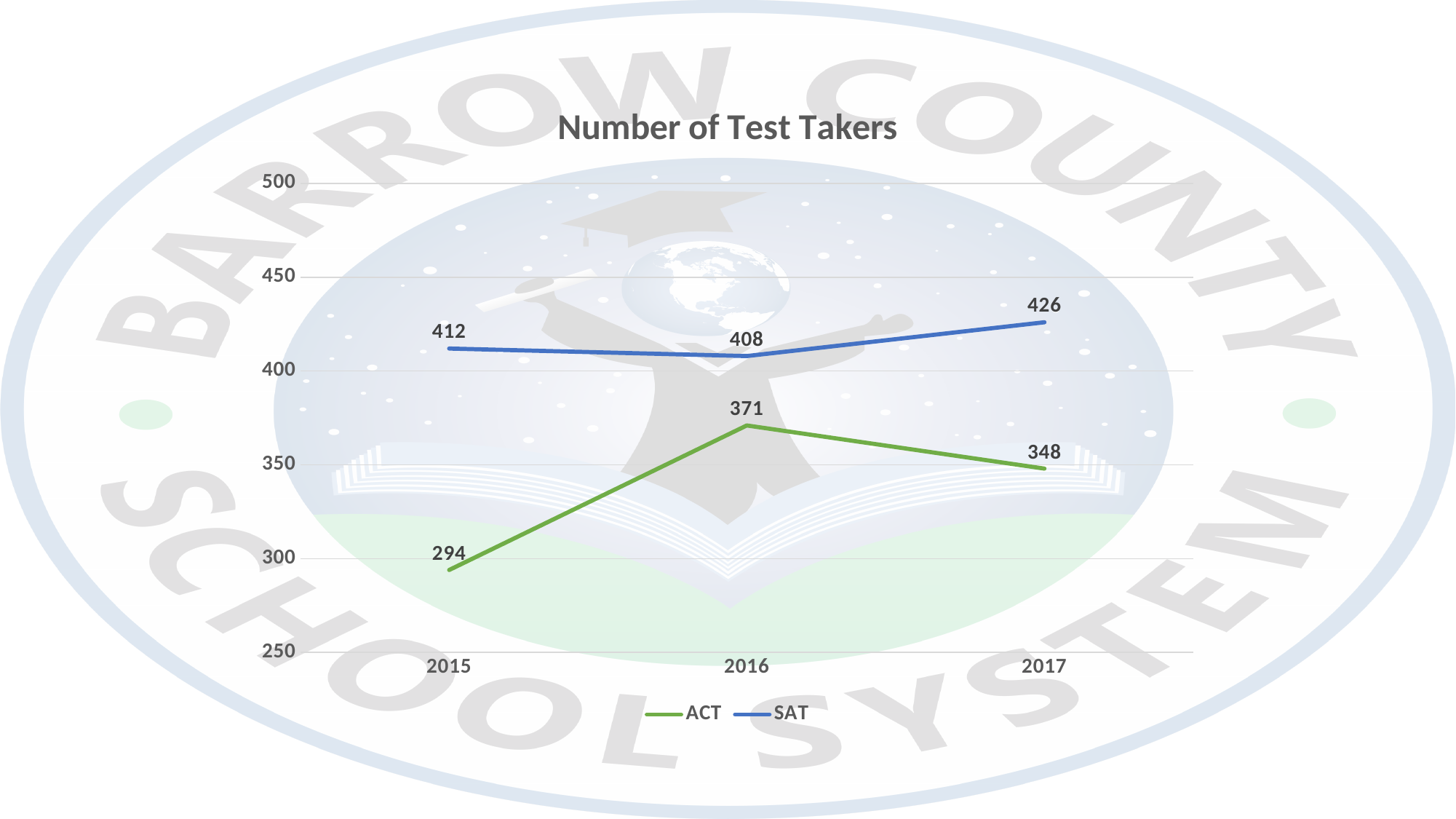
What kind of chart is shown on the slide? Line chart What is the number of ACT test takers in 2016? 371 What is the title of the chart? Number of Test Takers How many series does the legend list? 2 In which year was the number of ACT test takers highest? 2016 What is the difference between the number of SAT and ACT test takers in 2015? 118 How many years are shown on the x axis? 3 Which had more test takers in 2017, ACT or SAT? SAT What is the number of ACT test takers in 2015? 294 In which year was the number of SAT test takers lowest? 2016 What is the number of SAT test takers in 2016? 408 What is the number of SAT test takers in 2017? 426